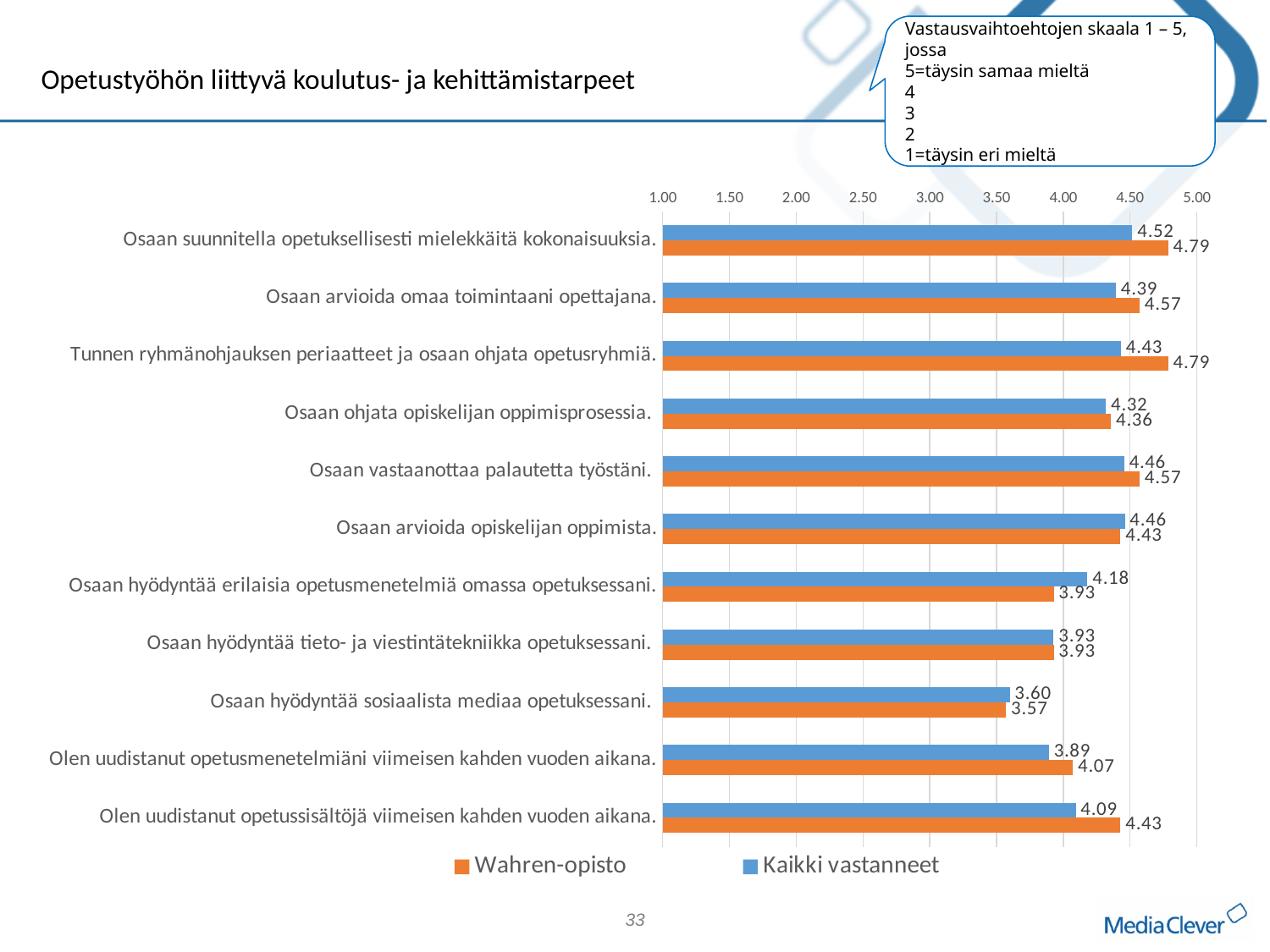
For "Osaan hyödyntää erilaisia opetusmenetelmiä omassa opetuksessani", which series has the larger value, Wahren-opisto or Kaikki vastanneet? Kaikki vastanneet How many categories are shown in the chart? 11 Which category has the highest Kaikki vastanneet value? Osaan suunnitella opetuksellisesti mielekkäitä kokonaisuuksia. What is the difference between the Wahren-opisto and Kaikki vastanneet values for "Olen uudistanut opetussisältöjä viimeisen kahden vuoden aikana"? 0.34 What is the Kaikki vastanneet value for "Osaan hyödyntää erilaisia opetusmenetelmiä omassa opetuksessani"? 4.18 Which category has the lowest Wahren-opisto value? Osaan hyödyntää sosiaalista mediaa opetuksessani. Which colour represents the Wahren-opisto series? Orange How many series does the legend list? 2 What kind of chart is shown on the slide? Bar chart What is the Wahren-opisto value for "Osaan suunnitella opetuksellisesti mielekkäitä kokonaisuuksia"? 4.79 What is the Wahren-opisto value for "Olen uudistanut opetussisältöjä viimeisen kahden vuoden aikana"? 4.43 Is the Wahren-opisto value for "Osaan hyödyntää sosiaalista mediaa opetuksessani" greater or less than 4.00? less